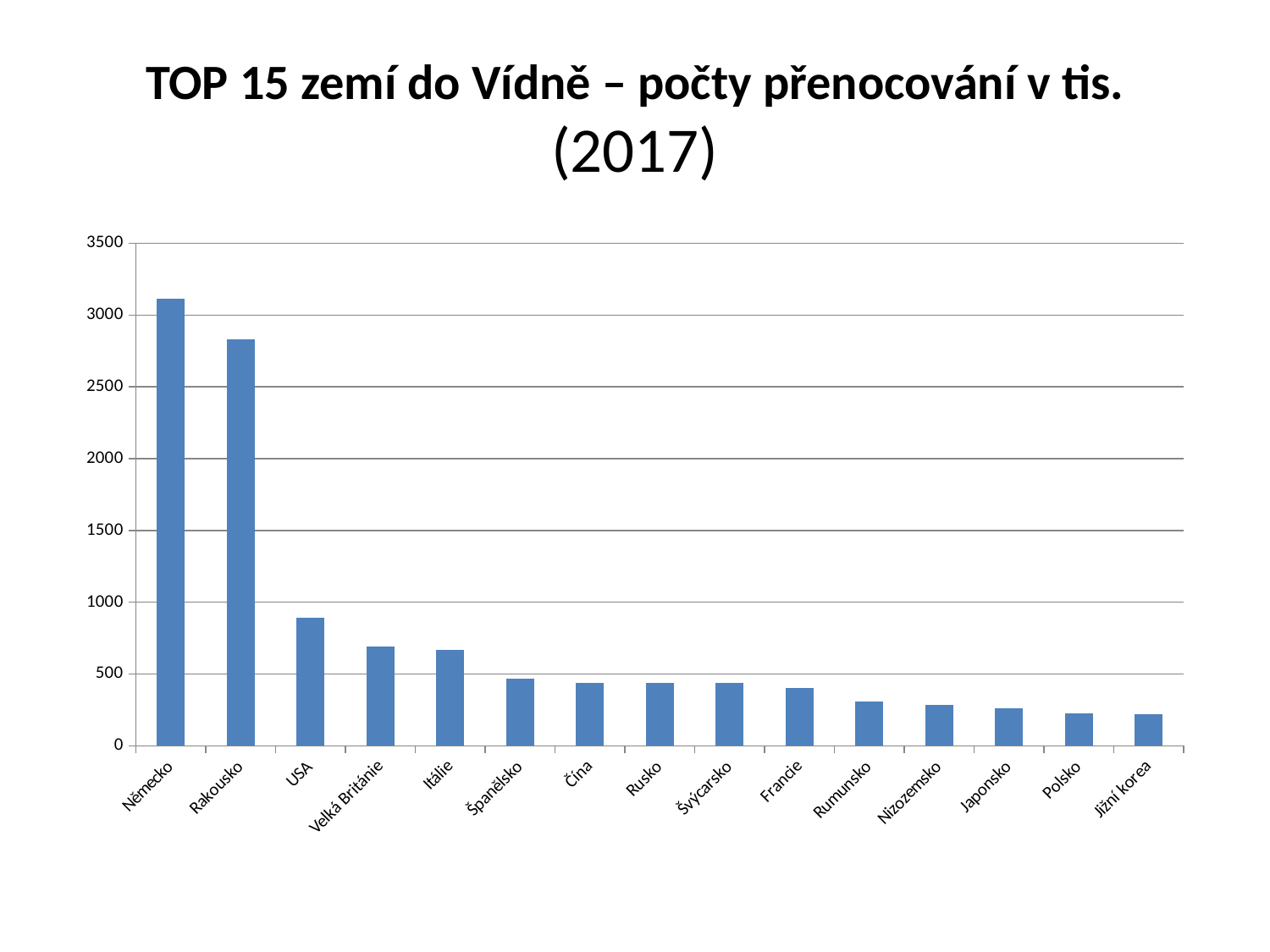
Which has a larger value, USA or Velká Británie? USA Is the value for Německo greater or less than 3000? greater Is the value for USA greater or less than 1000? less Which country has the highest number of overnight stays in the chart? Německo How many countries are shown on the x axis of the chart? 15 Which has a larger value, Německo or Rakousko? Německo Is the value for Velká Británie greater or less than 500? greater Which year does the chart title say the data is for? 2017 Do the values rise or fall from left to right along the x axis? fall What kind of chart is shown on the slide? bar chart